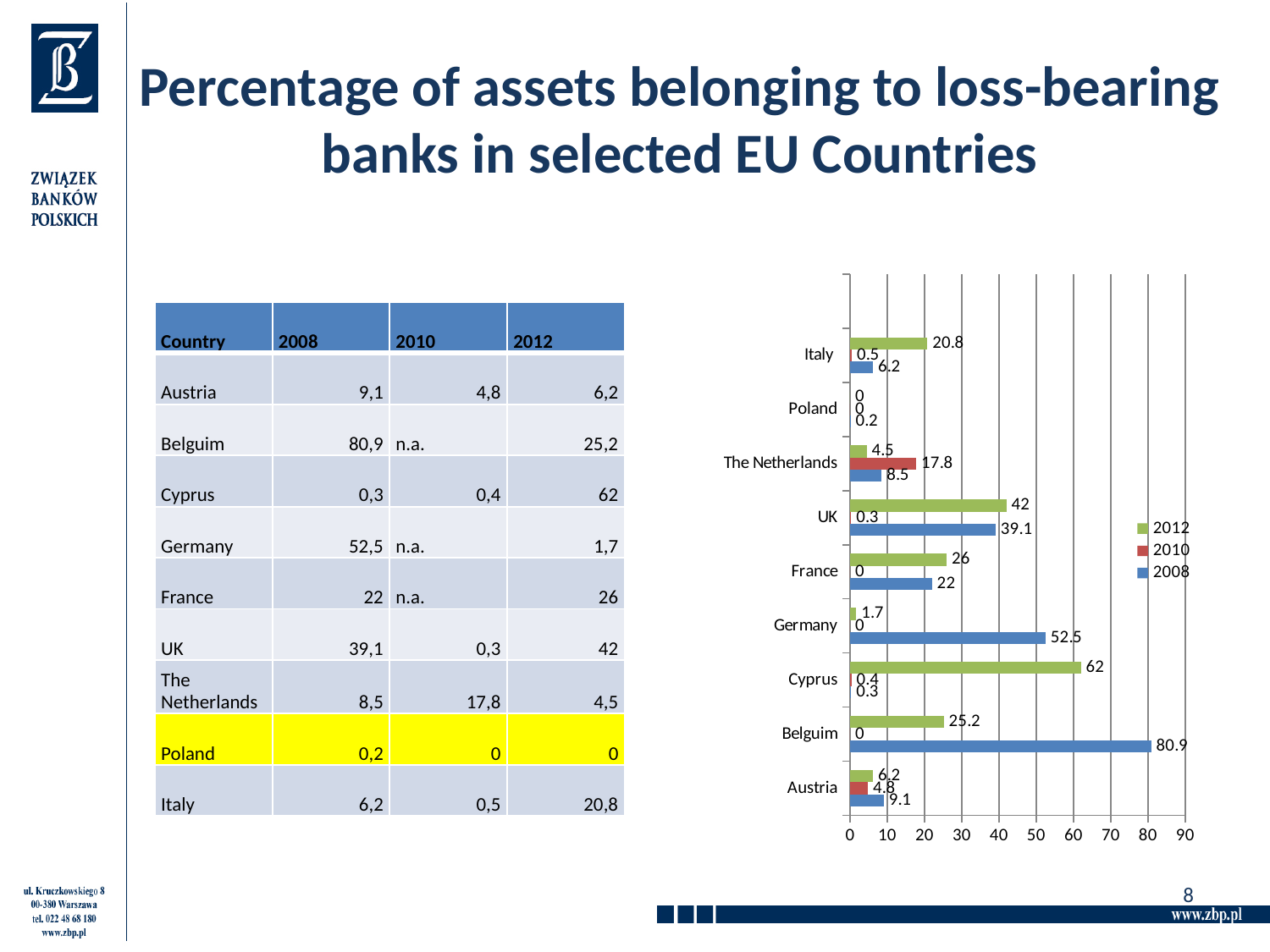
What is the 2012 value for Italy in the chart? 20.8 How many countries are plotted on the chart? 9 What kind of chart is shown on the slide? bar chart How many series does the chart legend list? 3 What is the difference between the 2012 and 2008 values for Germany in the chart? 50.8 Which colour represents the 2010 series in the chart? red Which is larger for the UK in the chart: the 2012 value or the 2008 value? 2012 Which country has the highest 2012 value in the chart? Cyprus What is the 2008 value for Belguim in the chart? 80.9 What is the 2012 value for Cyprus in the chart? 62 Which country has the highest 2008 value in the chart? Belguim What is the 2010 value for The Netherlands in the chart? 17.8